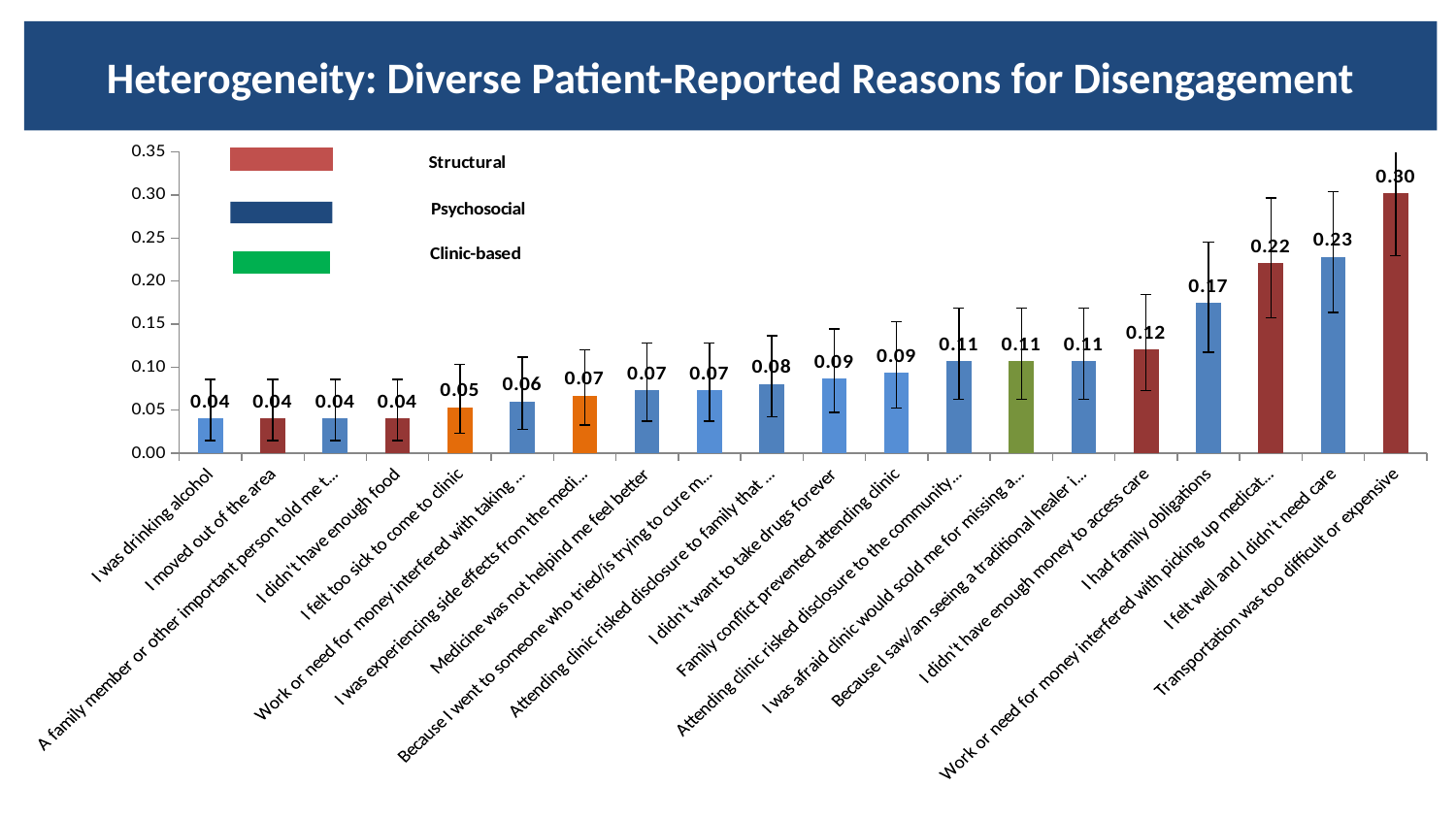
Which is larger: the value for 'I had family obligations' or the value for 'I didn't have enough money to access care'? I had family obligations What is the difference between the values for 'Transportation was too difficult or expensive' and 'I felt well and I didn't need care'? 0.07 How many categories does the legend list? 3 What type of chart is shown on the slide? Bar chart Is the value for 'I felt well and I didn't need care' greater or less than 0.20? greater Which reason has the highest value? Transportation was too difficult or expensive What is the value for 'I didn't want to take drugs forever'? 0.09 What is the lowest value shown on the chart? 0.04 How many reasons (bars) are shown on the chart? 20 What is the value for 'I had family obligations'? 0.17 What is the value for 'I felt well and I didn't need care'? 0.23 What is the value for 'Transportation was too difficult or expensive'? 0.30